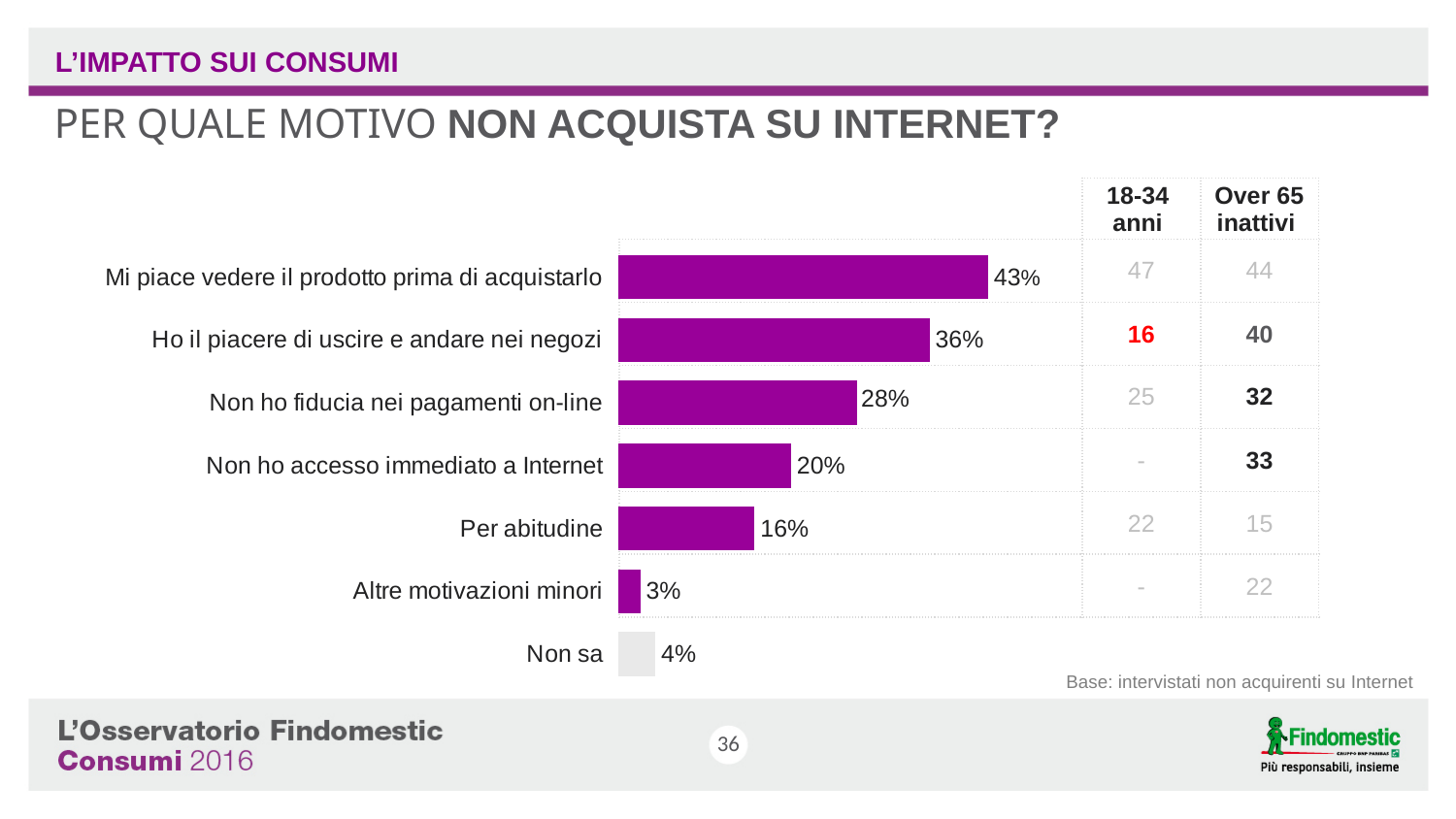
What is the title of the chart on the slide? PER QUALE MOTIVO NON ACQUISTA SU INTERNET? What percentage is shown for 'Per abitudine'? 16% What is the difference in percentage points between 'Mi piace vedere il prodotto prima di acquistarlo' and 'Ho il piacere di uscire e andare nei negozi'? 7 percentage points What is the value shown for 'Non ho fiducia nei pagamenti on-line'? 28% In the table next to the chart, what is the value for 'Ho il piacere di uscire e andare nei negozi' among 18-34 anni? 16 Which reason has the highest percentage in the chart? Mi piace vedere il prodotto prima di acquistarlo How many categories (bars) are shown in the chart? 7 What type of chart is shown on the slide? Bar chart Which is larger: 'Non ho accesso immediato a Internet' or 'Per abitudine'? Non ho accesso immediato a Internet Which category has the lowest value in the chart? Altre motivazioni minori What is the value for 'Non sa'? 4% What percentage of respondents say 'Mi piace vedere il prodotto prima di acquistarlo'? 43%